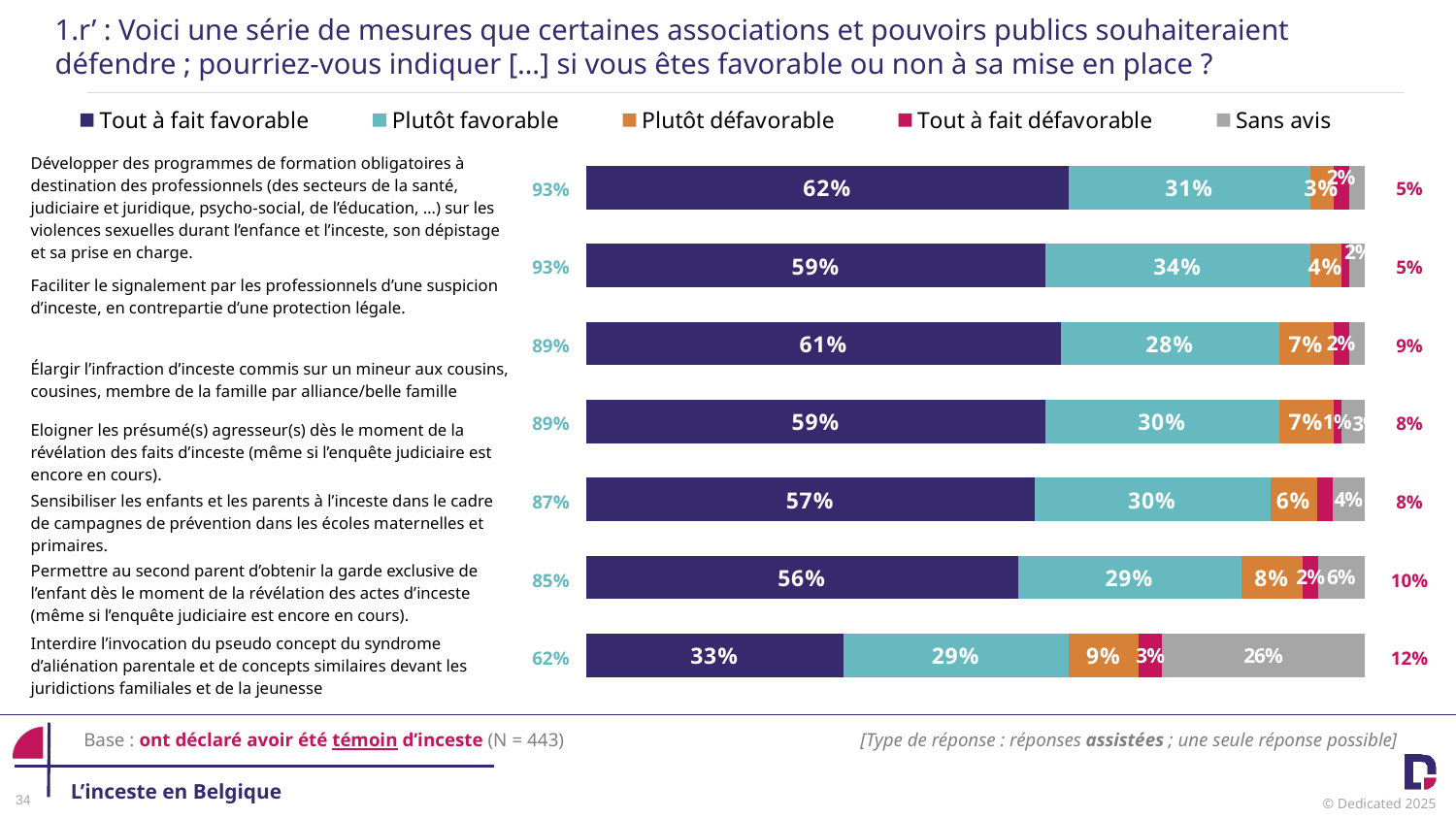
What colour represents the 'Tout à fait favorable' series in the chart? Dark purple What is the 'Plutôt favorable' value for 'Faciliter le signalement par les professionnels d'une suspicion d'inceste'? 34% What is the 'Plutôt défavorable' value for 'Élargir l'infraction d'inceste commis sur un mineur aux cousins, cousines'? 7% What is the 'Sans avis' value for 'Interdire l'invocation du pseudo concept du syndrome d'aliénation parentale'? 26% Which measure has the lowest 'Tout à fait favorable' value? Interdire l'invocation du pseudo concept du syndrome d'aliénation parentale How many measures (categories) are plotted in the chart? 7 What is the 'Tout à fait favorable' value for 'Interdire l'invocation du pseudo concept du syndrome d'aliénation parentale'? 33% What kind of chart is shown on the slide? Stacked bar chart How many series does the legend list? 5 What is the difference between the 'Tout à fait favorable' values for 'Développer des programmes de formation obligatoires' (62%) and 'Permettre au second parent d'obtenir la garde exclusive' (56%)? 6% Which measure has the highest 'Tout à fait favorable' value? Développer des programmes de formation obligatoires à destination des professionnels Which is larger: the 'Plutôt défavorable' value for 'Permettre au second parent d'obtenir la garde exclusive' or for 'Sensibiliser les enfants et les parents à l'inceste'? Permettre au second parent d'obtenir la garde exclusive